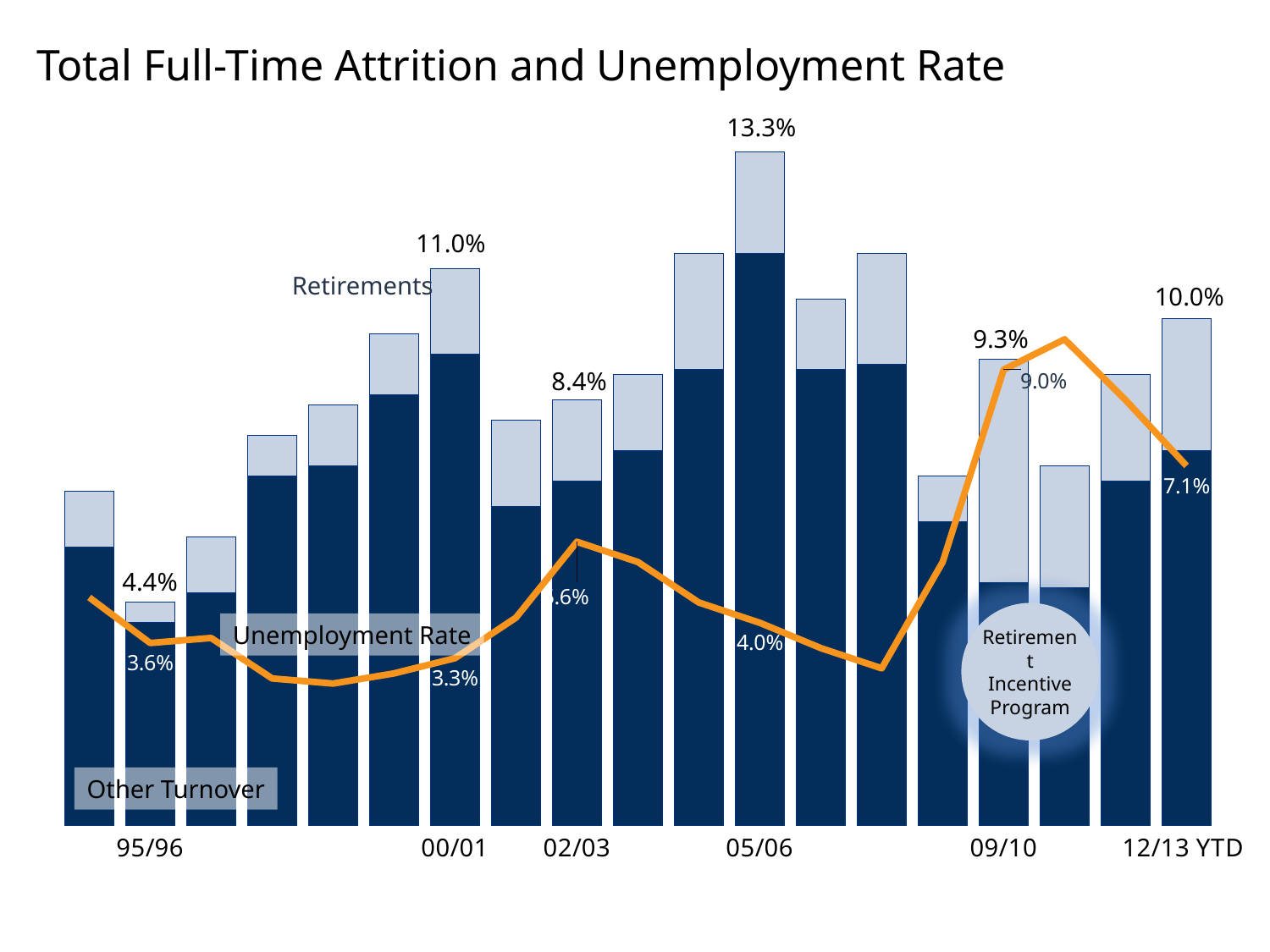
Does the unemployment rate line rise or fall from 09/10 to 12/13 YTD? Fall What is the total full-time attrition rate for 00/01? 11.0% What is the unemployment rate shown for 12/13 YTD? 7.1% What is the difference between the unemployment rate in 09/10 and in 00/01? 5.7 percentage points What is the total full-time attrition rate for 05/06? 13.3% What is the difference between the total attrition rate in 05/06 and in 95/96? 8.9 percentage points How many bars are plotted in the chart? 19 Which year has the highest total full-time attrition rate? 05/06 How many data series are labelled on the chart? 3 What kind of chart is shown on the slide? Stacked bar chart with a line Which year has the higher total attrition rate, 00/01 or 02/03? 00/01 What is the unemployment rate shown for 09/10? 9.0%